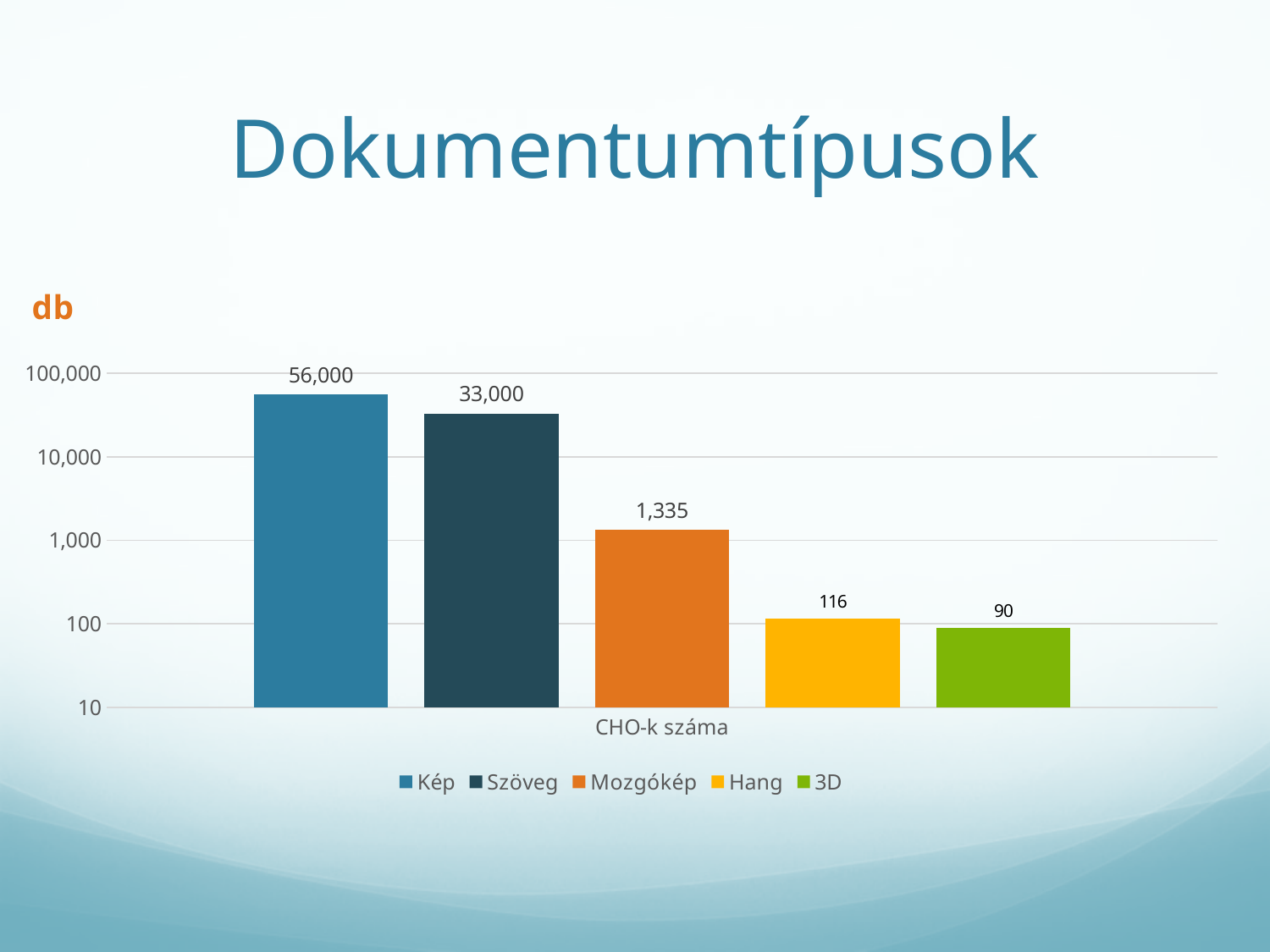
What is the title of the slide containing the chart? Dokumentumtípusok Which series has the lowest value? 3D What is the value for 3D? 90 What is the value for Kép? 56,000 What is the value for Mozgókép? 1,335 Which series has the highest value? Kép How many series does the legend list? 5 Which is larger, the value for Hang or the value for 3D? Hang What is the value for Szöveg? 33,000 What is the difference between the values for Kép and Szöveg? 23,000 What is the value for Hang? 116 What kind of chart is shown on the slide? Bar chart